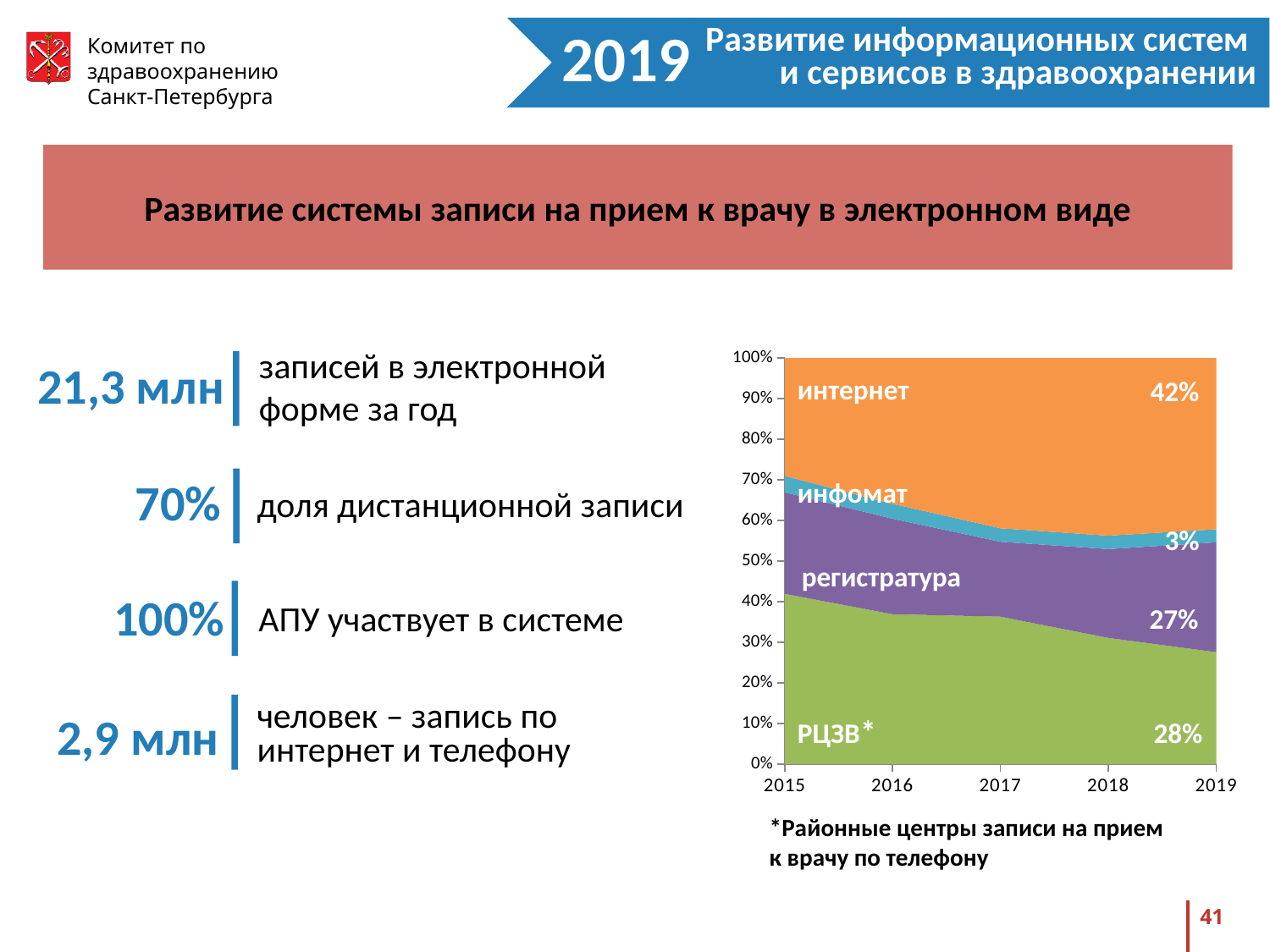
What share does инфомат have in 2019 on the chart? 3% How many years are shown on the x axis of the chart? 5 What is the difference between the 2019 shares of интернет and регистратура? 15% What kind of chart is shown on the slide? stacked area chart Does the share of РЦЗВ* rise or fall from 2015 to 2019? fall What share does интернет have in 2019 on the chart? 42% What share does РЦЗВ* have in 2019 on the chart? 28% In 2019, which is larger: the share of РЦЗВ* or the share of регистратура? РЦЗВ* Is the share of интернет in 2015 greater or less than 40%? less What share does регистратура have in 2019 on the chart? 27% Which channel has the largest share in 2019? интернет Which channel has the smallest share in 2019? инфомат